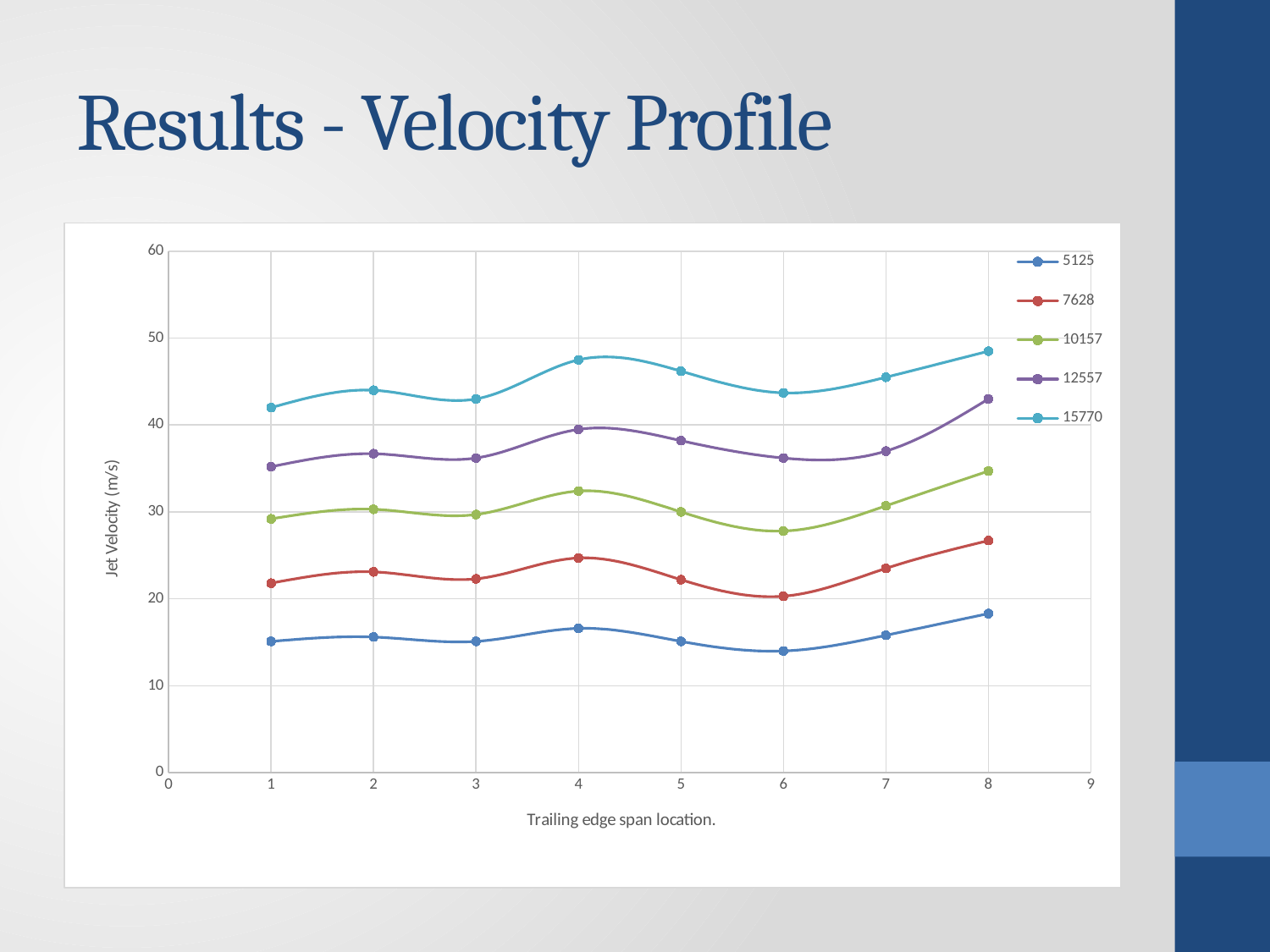
Is the value for the 15770 series at span location 4 greater or less than 40? greater How many data points are plotted for the 5125 series? 8 For the 12557 series, is the value larger at span location 8 or at span location 1? span location 8 What kind of chart is shown on the slide? line chart Is the value for the 7628 series at span location 8 greater or less than 25? greater At which span location does the 7628 series reach its lowest value? 6 Which series has the lowest jet velocity values across the trailing edge span locations? 5125 Which series has the highest jet velocity values across the trailing edge span locations? 15770 How many series does the legend list? 5 Is the value for the 5125 series at span location 6 greater or less than 20? less What is the title of the y axis? Jet Velocity (m/s)